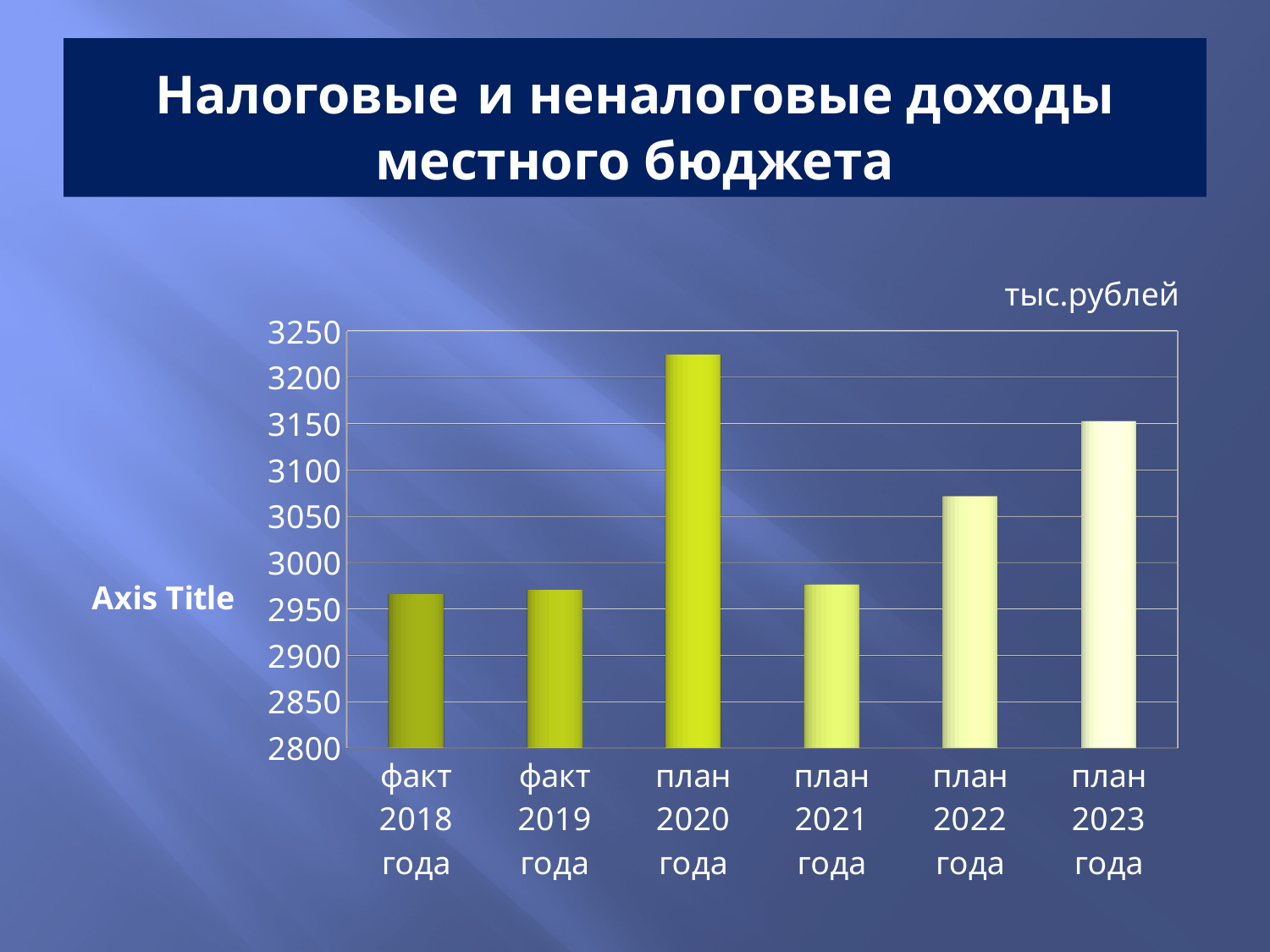
Is the value for план 2020 года greater or less than 3200? greater Is the value for план 2023 года greater or less than 3100? greater How many categories (bars) are shown in the chart? 6 Is the value for план 2022 года greater or less than 3100? less Which is larger, the value for план 2022 года or план 2023 года? план 2023 года Which category has the highest value in the chart? план 2020 года What unit is indicated above the chart? тыс.рублей Which is larger, the value for план 2020 года or план 2023 года? план 2020 года What kind of chart is shown on the slide? bar chart Do the values rise or fall from план 2021 года to план 2023 года? rise